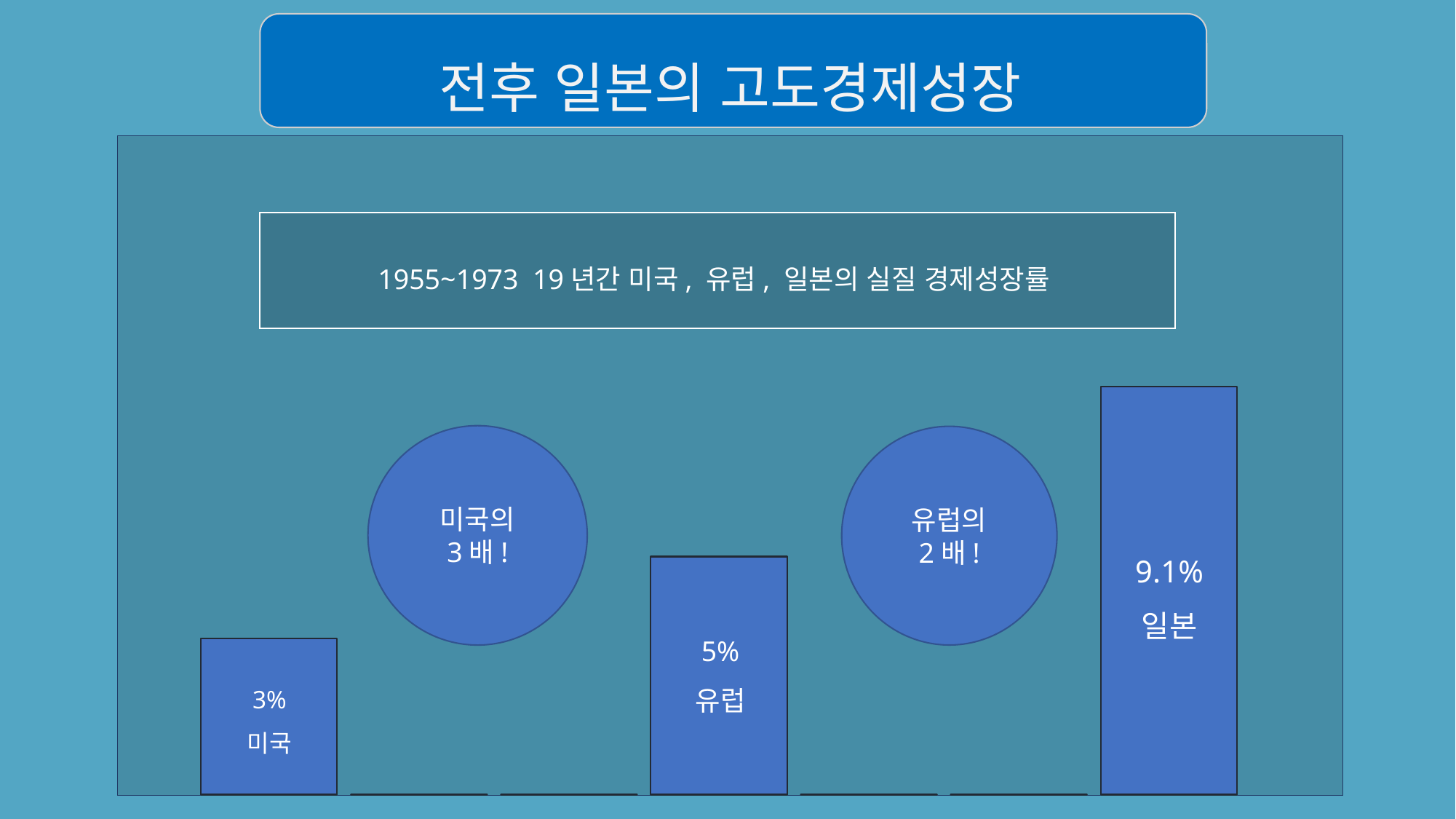
What is the difference between the growth rates of 유럽 and 미국? 2% What period does the chart's heading say the growth rates cover? 1955~1973 What is the real economic growth rate shown for 유럽 (Europe)? 5% What is the real economic growth rate shown for 일본 (Japan)? 9.1% Which country or region has the highest growth rate on the chart? 일본 Which country or region has the lowest growth rate on the chart? 미국 What kind of chart is shown on the slide? Bar chart Which has a larger growth rate, 유럽 or 미국? 유럽 What is the difference between the growth rates of 일본 and 미국? 6.1% How many countries or regions are shown as bars on the chart? 3 Do the bar values rise or fall from left to right across the chart? Rise What is the real economic growth rate shown for 미국 (USA)? 3%